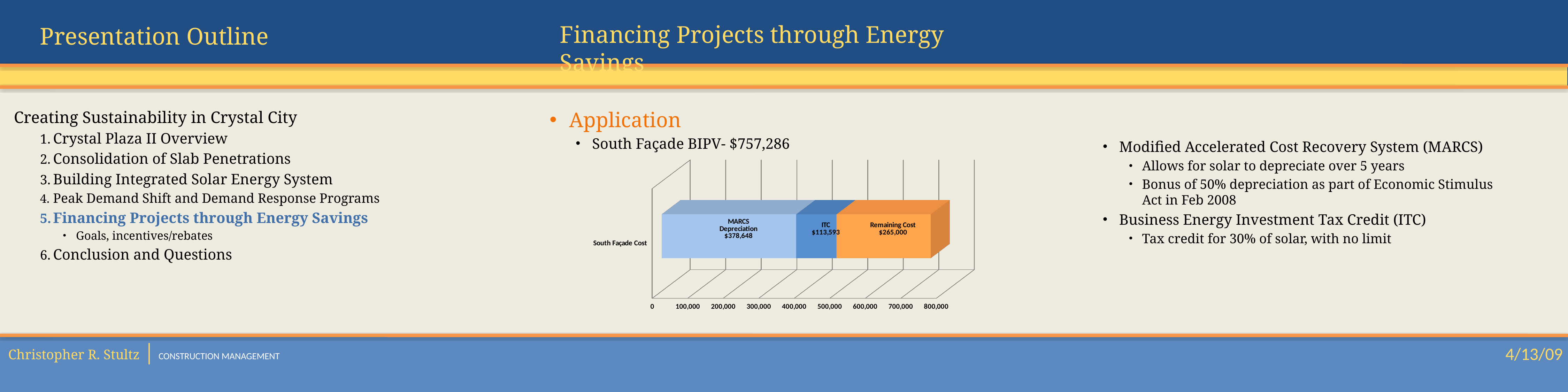
What is the value of the MARCS Depreciation segment in the South Façade Cost bar? $378,648 What is the label of the single category on the chart's vertical axis? South Façade Cost What is the value of the ITC segment in the chart? $113,593 What is the value of the Remaining Cost segment in the chart? $265,000 Which segment of the South Façade Cost bar has the smallest value? ITC Which is larger, the ITC segment or the Remaining Cost segment? Remaining Cost What is the difference between the Remaining Cost segment and the ITC segment? $151,407 What is the difference between the MARCS Depreciation segment and the Remaining Cost segment? $113,648 Is the total length of the South Façade Cost bar greater or less than 700,000? greater How many categories (bars) does the chart show? 1 Which segment of the South Façade Cost bar has the largest value? MARCS Depreciation What kind of chart is shown on the slide? Stacked bar chart